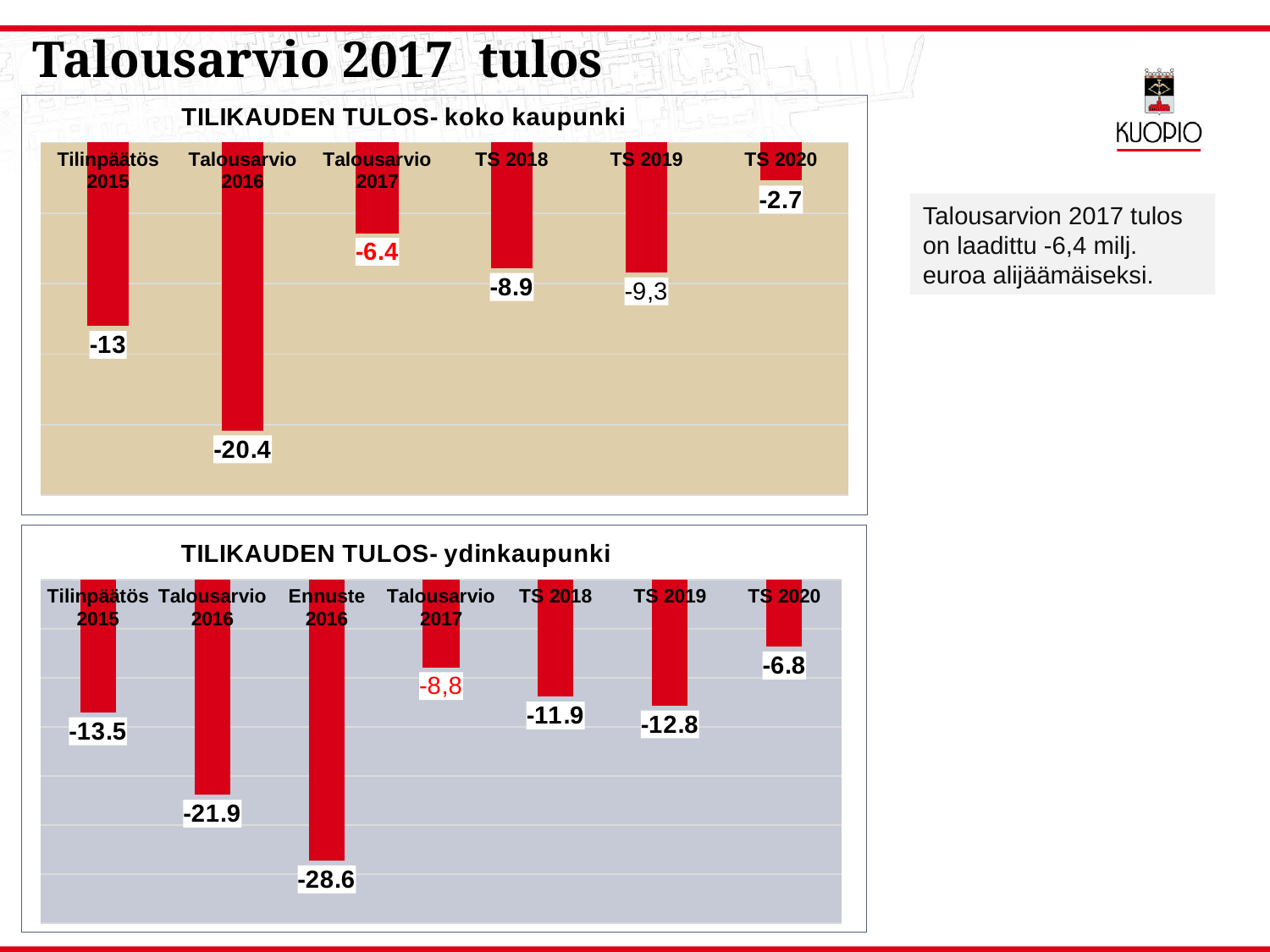
In the chart titled "TILIKAUDEN TULOS- ydinkaupunki", what is the value for TS 2019? -12.8 In the chart titled "TILIKAUDEN TULOS- koko kaupunki", which category has the lowest value? Talousarvio 2016 In the chart titled "TILIKAUDEN TULOS- koko kaupunki", how many categories are plotted? 6 In the chart titled "TILIKAUDEN TULOS- koko kaupunki", which category has the highest value? TS 2020 In the chart titled "TILIKAUDEN TULOS- ydinkaupunki", what is the value for Ennuste 2016? -28.6 What kind of chart is the bottom chart on the slide? Bar chart In the chart titled "TILIKAUDEN TULOS- ydinkaupunki", which category has the lowest value? Ennuste 2016 In the chart titled "TILIKAUDEN TULOS- ydinkaupunki", how many categories are plotted? 7 In the chart titled "TILIKAUDEN TULOS- koko kaupunki", what is the value for Talousarvio 2017? -6.4 In the chart titled "TILIKAUDEN TULOS- ydinkaupunki", which is larger, the value for Tilinpäätös 2015 or the value for TS 2018? TS 2018 In the chart titled "TILIKAUDEN TULOS- koko kaupunki", what is the value for TS 2020? -2.7 In the chart titled "TILIKAUDEN TULOS- koko kaupunki", what is the difference between the values for Tilinpäätös 2015 and Talousarvio 2016? 7.4